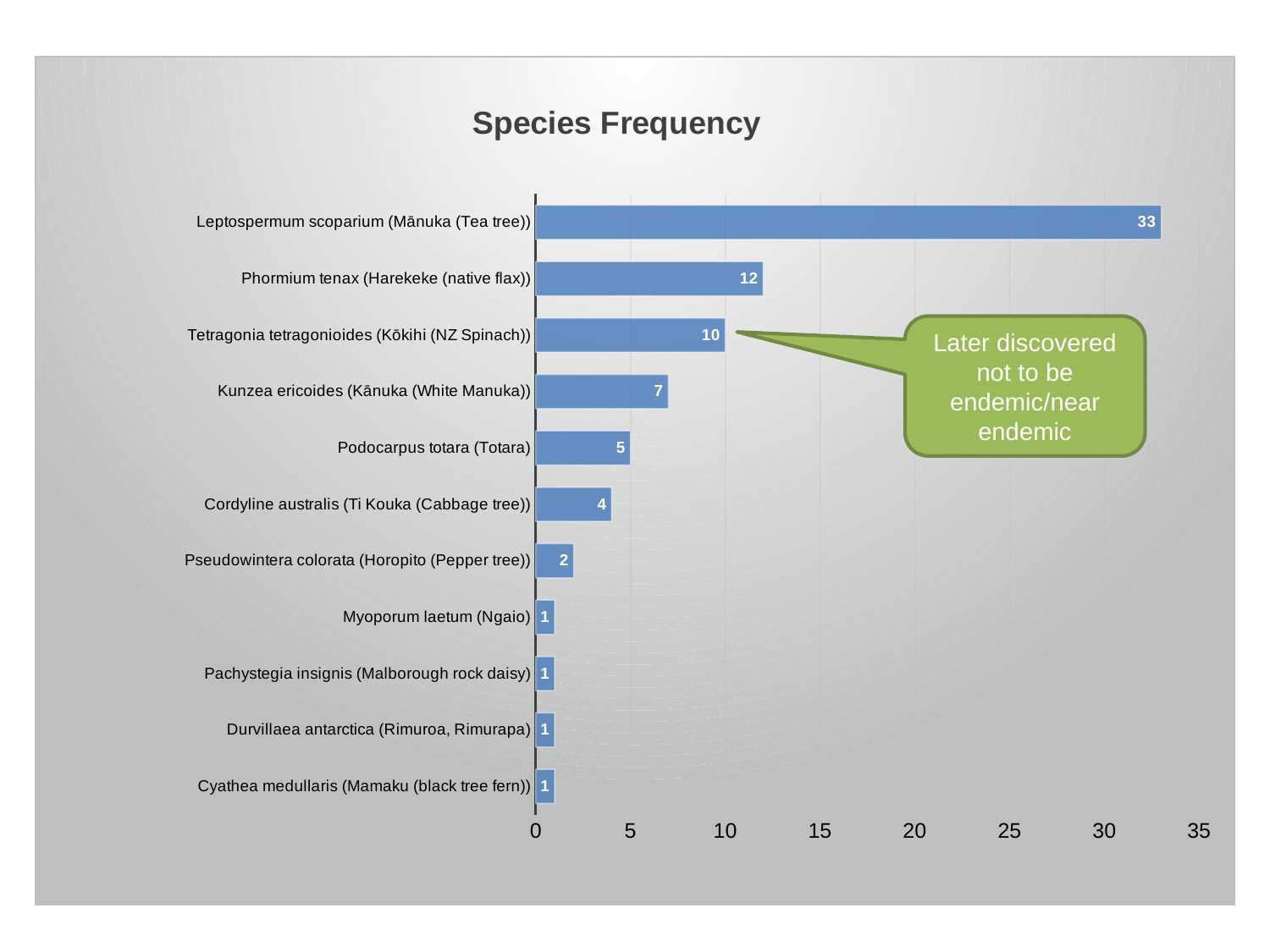
How many species have a value of 1? 4 Is the value for Tetragonia tetragonioides (Kōkihi (NZ Spinach)) greater or less than 5? greater What is the title of the chart? Species Frequency What is the value for Leptospermum scoparium (Mānuka (Tea tree))? 33 What is the value for Podocarpus totara (Totara)? 5 Which is larger, the value for Kunzea ericoides (Kānuka (White Manuka)) or the value for Cordyline australis (Ti Kouka (Cabbage tree))? Kunzea ericoides (Kānuka (White Manuka)) What kind of chart is shown on the slide? bar chart Which species has the highest frequency? Leptospermum scoparium (Mānuka (Tea tree)) How many species are shown in the chart? 11 What is the value for Phormium tenax (Harekeke (native flax))? 12 What is the difference between the values for Leptospermum scoparium (Mānuka (Tea tree)) and Phormium tenax (Harekeke (native flax))? 21 What does the callout pointing at the Tetragonia tetragonioides bar say? Later discovered not to be endemic/near endemic